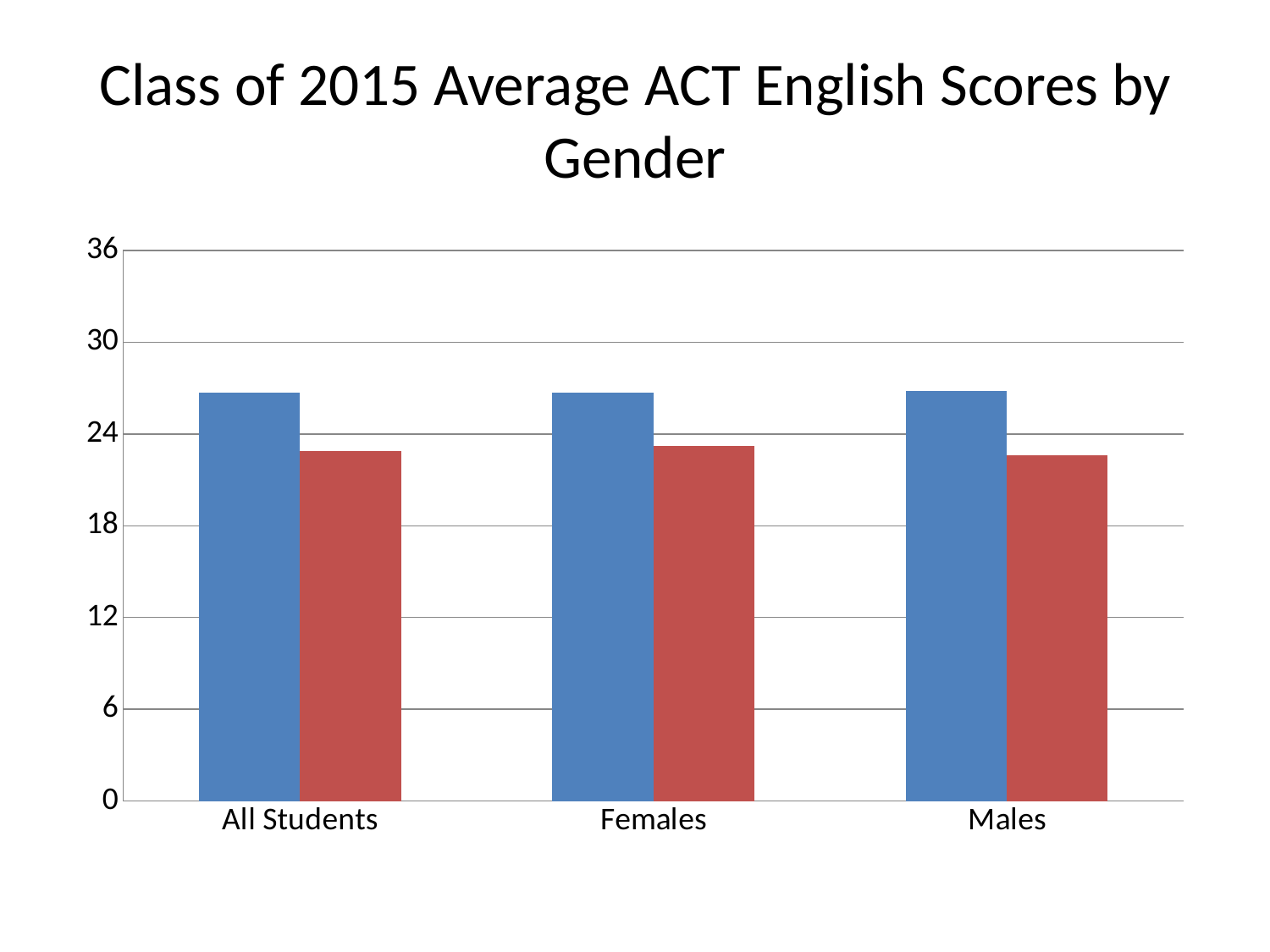
What is the highest value shown on the y axis? 36 For Males, which bar is shorter, the blue bar or the red bar? the red bar For Females, which bar is taller, the blue bar or the red bar? the blue bar What is the title of the chart? Class of 2015 Average ACT English Scores by Gender Is the value of the red bar for All Students greater or less than 24? less How many bars are shown for each category? 2 How many categories are shown on the x axis? 3 Is the value of the blue bar for Females greater or less than 30? less Is the value of the blue bar for Males greater or less than 24? greater What kind of chart is shown on the slide? bar chart